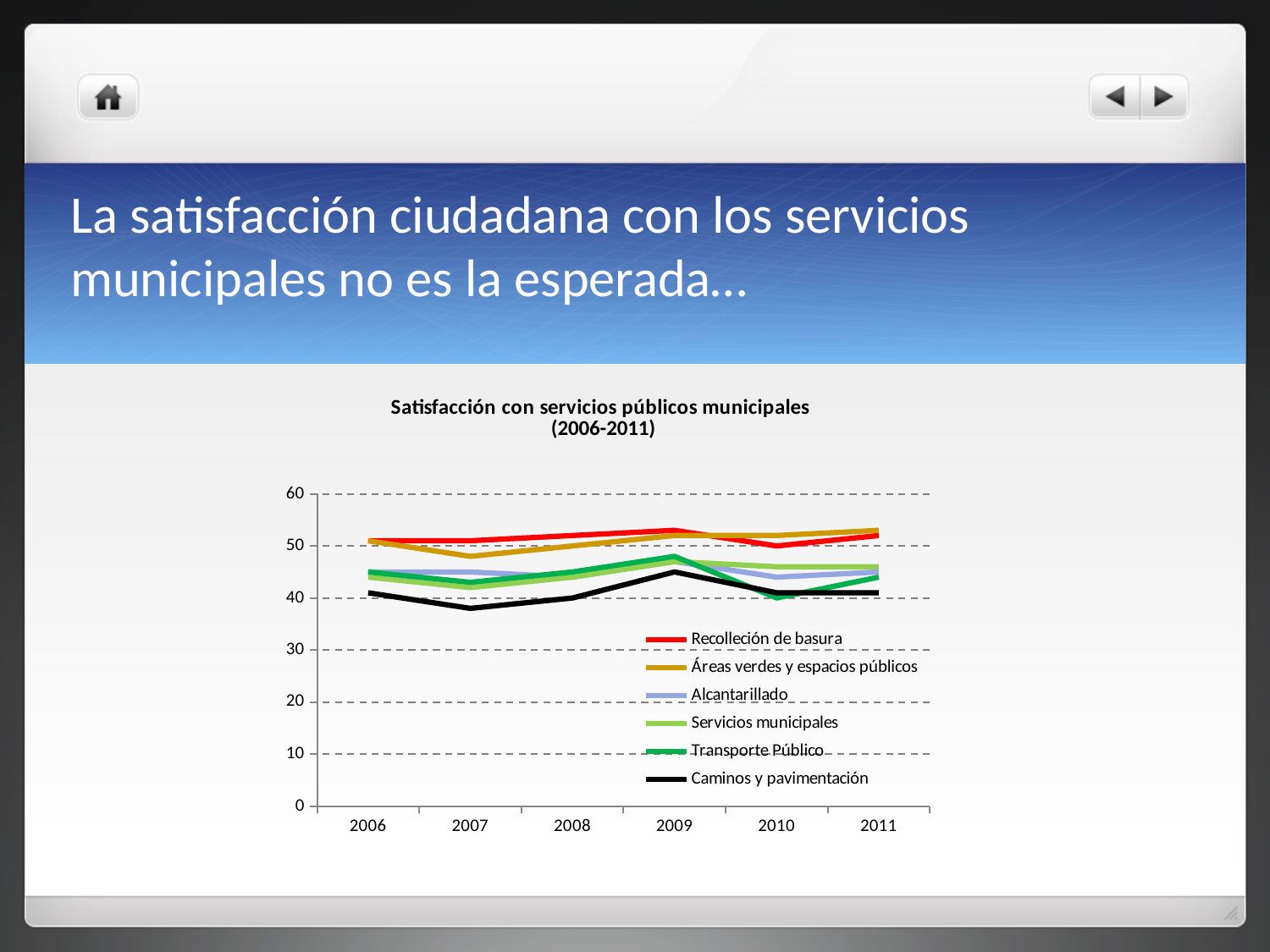
What is the title of the chart? Satisfacción con servicios públicos municipales (2006-2011) Is the value for Caminos y pavimentación in 2007 greater or less than 40? less Is the value for Caminos y pavimentación in 2009 greater or less than 40? greater Does the value for Caminos y pavimentación rise or fall from 2006 to 2007? fall Is the value for Recolleción de basura in 2009 greater or less than 50? greater What colour is the line for Recolleción de basura? red In 2007, which is larger: Recolleción de basura or Áreas verdes y espacios públicos? Recolleción de basura How many years are shown on the x axis? 6 How many series does the legend list? 6 What kind of chart is shown on the slide? line chart Which series has the lowest value in 2007? Caminos y pavimentación